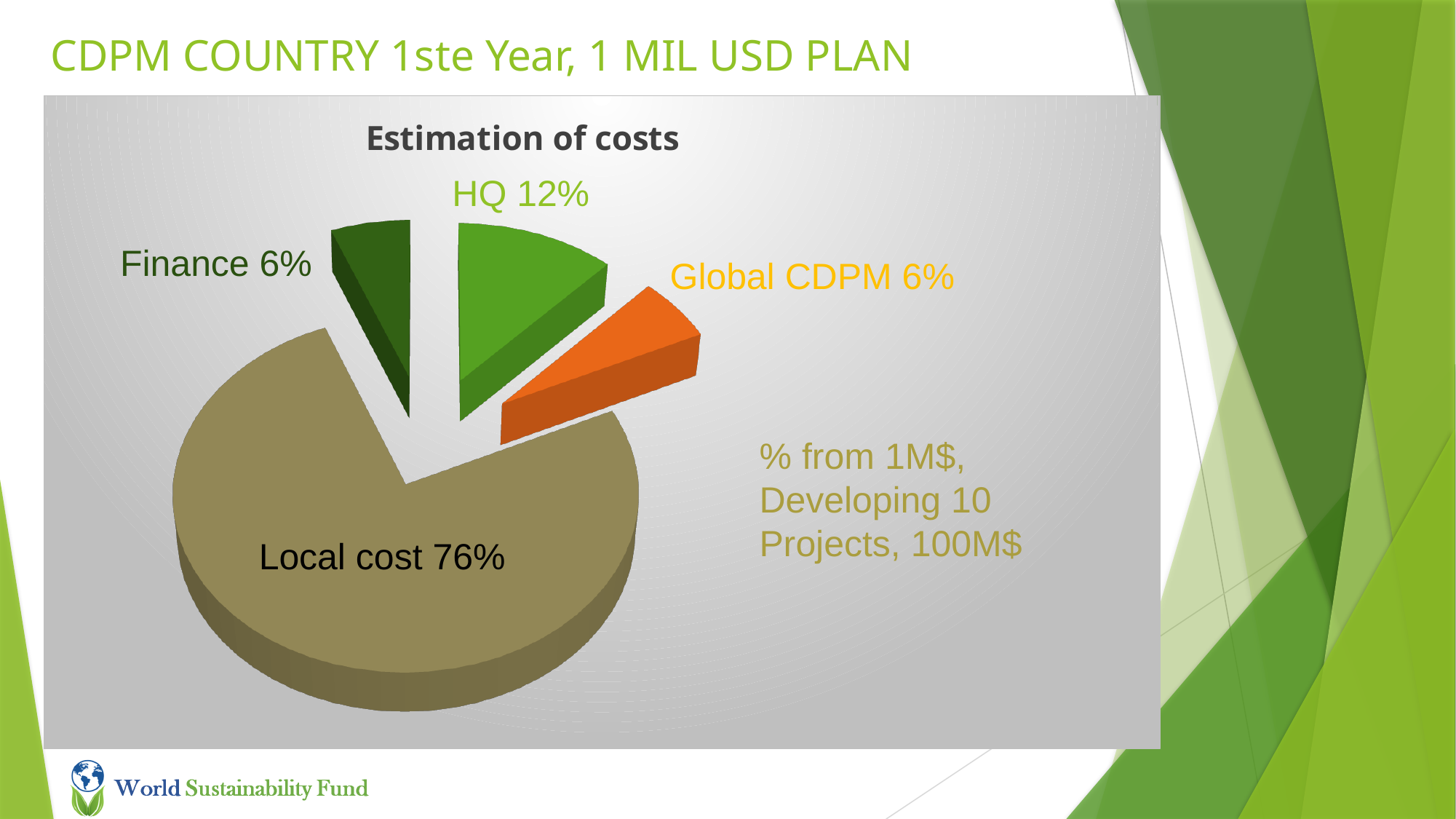
Which category has the largest slice of the pie? Local cost What share of the pie does Global CDPM represent? 6% Which is larger, the HQ slice or the Global CDPM slice? HQ What share of the pie does HQ represent? 12% What is the difference in percentage points between Local cost and HQ? 64 What kind of chart is shown on the slide? pie chart What is the difference in percentage points between HQ and Finance? 6 What share of the pie does Finance represent? 6% What is the title of the chart? Estimation of costs What colour is the Global CDPM slice? orange How many slices does the pie chart have? 4